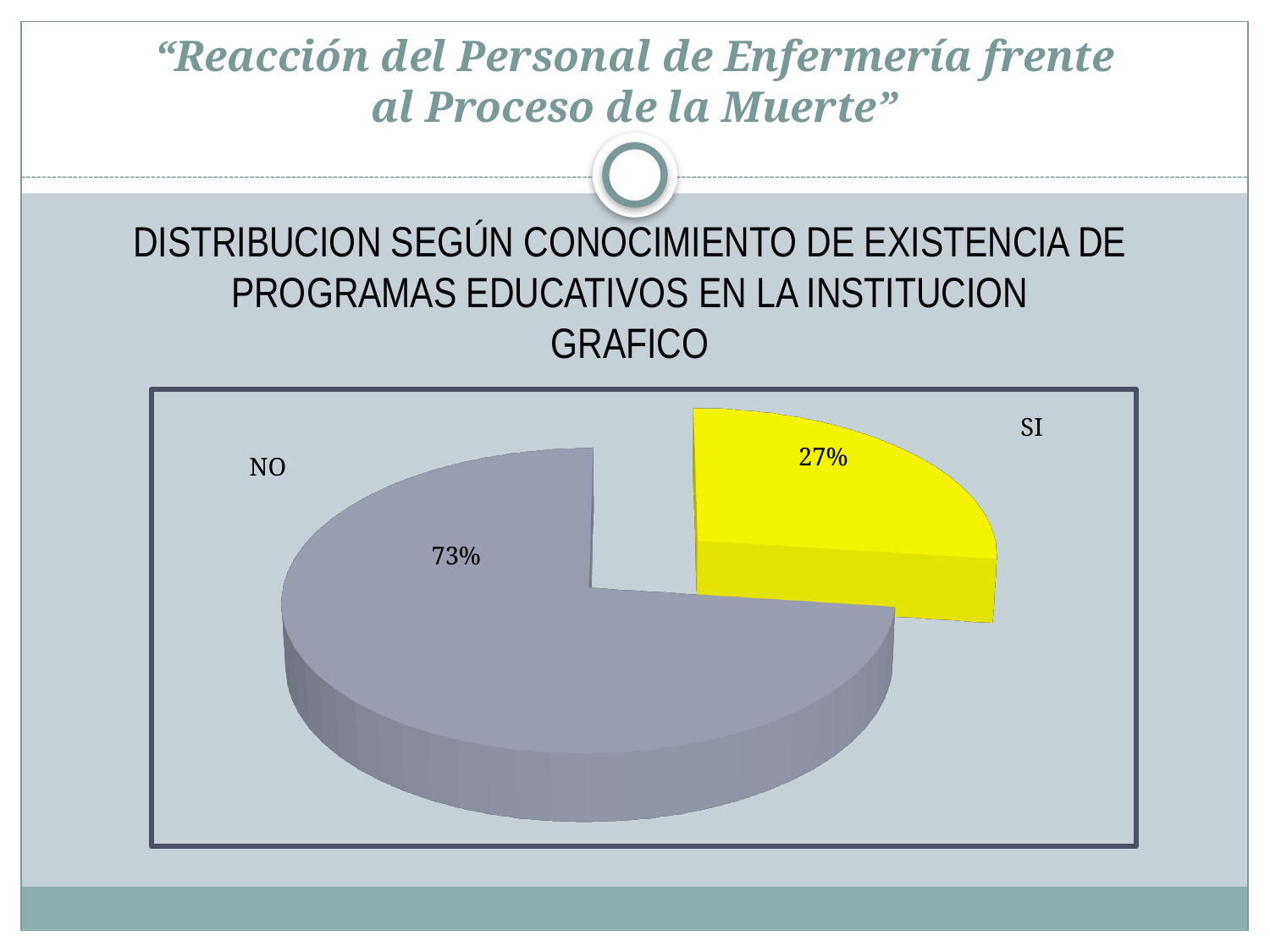
What percentage of the pie does the SI slice represent? 27% What kind of chart is shown on the slide? Pie chart How many slices does the pie chart have? 2 What percentage of the pie does the NO slice represent? 73% Which category has the smallest share of the pie? SI What is the difference in percentage points between the NO and SI slices? 46 What is the share of the SI slice in the pie? 27% Which slice is pulled out (exploded) from the pie? SI Which slice is larger, NO or SI? NO Which category has the largest share of the pie? NO What colour is the SI slice? Yellow